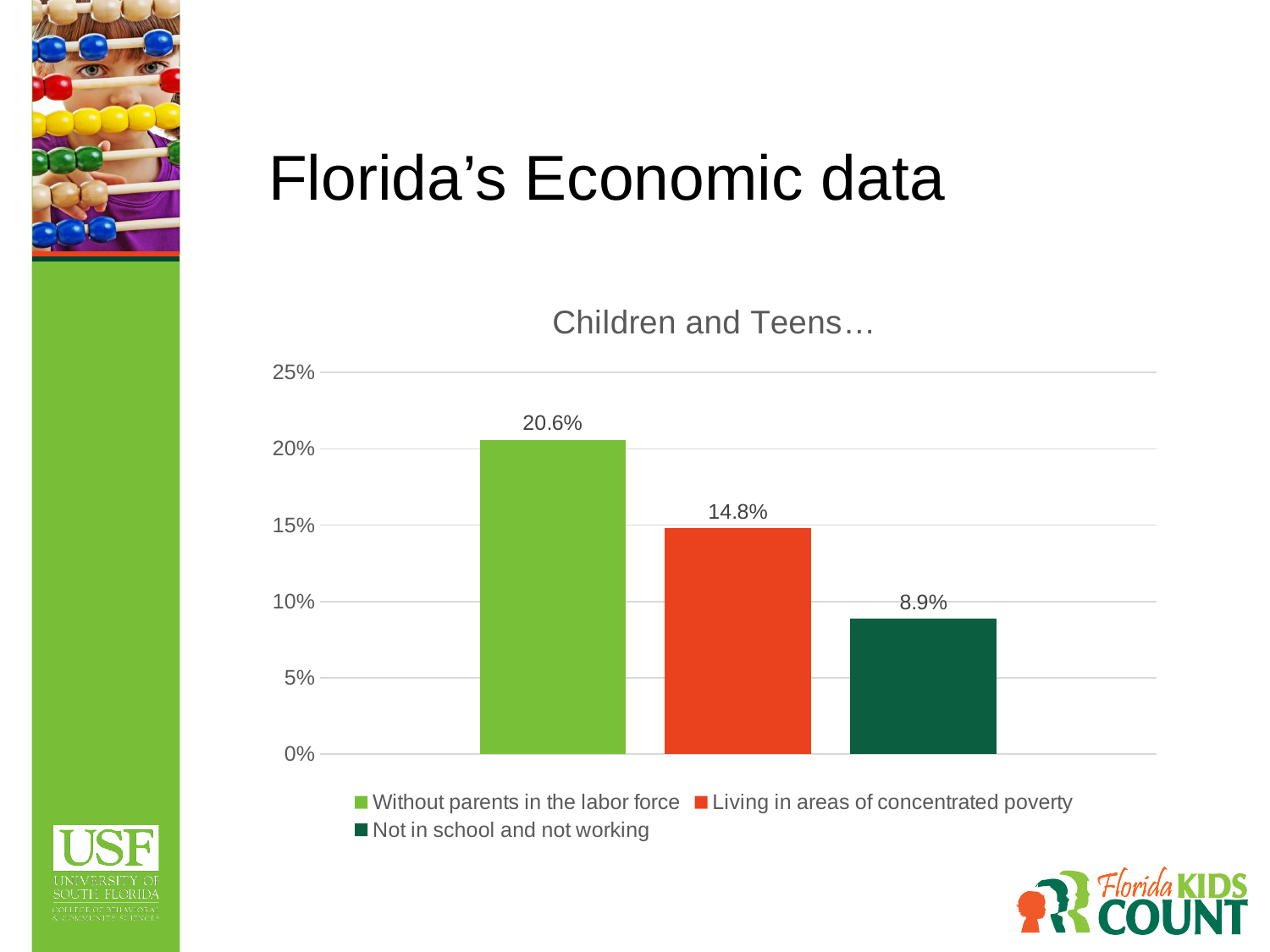
How many bars are plotted in the chart? 3 What is the difference between the value for living in areas of concentrated poverty and the value for not in school and not working? 5.9% Which category has the highest value? Without parents in the labor force What is the title of the chart? Children and Teens… What is the value for children and teens not in school and not working? 8.9% Is the value for without parents in the labor force greater or less than 20%? greater What is the value for children and teens without parents in the labor force? 20.6% Which is larger: the value for living in areas of concentrated poverty or the value for not in school and not working? Living in areas of concentrated poverty What is the value for children and teens living in areas of concentrated poverty? 14.8% What is the difference between the value for without parents in the labor force and the value for living in areas of concentrated poverty? 5.8% Which category has the lowest value? Not in school and not working What kind of chart is shown on the slide? Bar chart